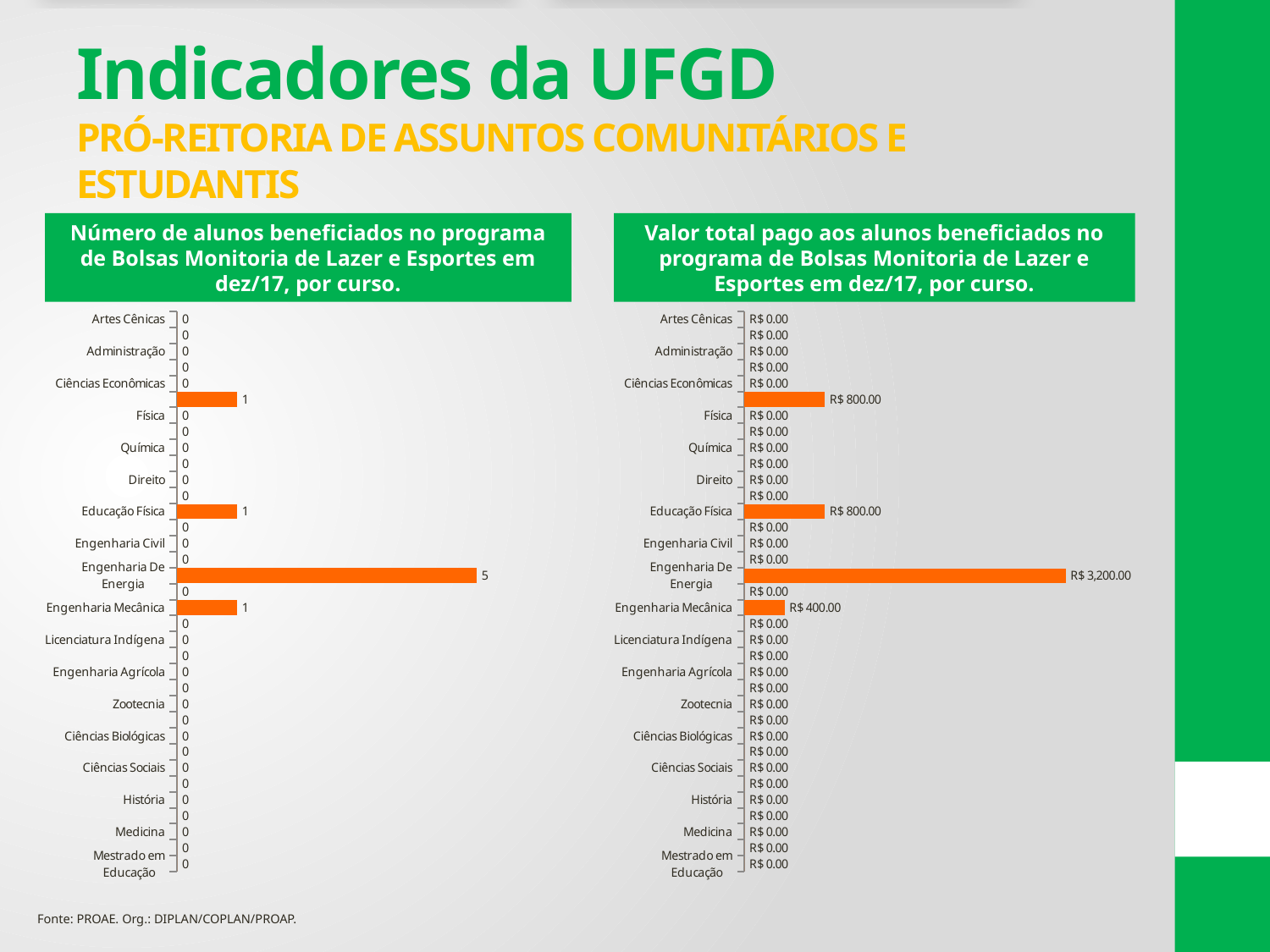
In the right chart (Valor total pago), what is the value for Engenharia Mecânica? R$ 400.00 In the left chart (Número de alunos beneficiados), what is the value for Medicina? 0 In the right chart (Valor total pago), which is larger: the value for Educação Física or the value for Engenharia Mecânica? Educação Física In the right chart (Valor total pago), what is the value for Engenharia De Energia? R$ 3,200.00 In the left chart (Número de alunos beneficiados), what is the value for Educação Física? 1 What type of chart is the left chart (Número de alunos beneficiados)? Bar chart In the left chart (Número de alunos beneficiados), which course has the highest number of students? Engenharia De Energia In the left chart (Número de alunos beneficiados), how many students are shown for Engenharia De Energia? 5 In the left chart (Número de alunos beneficiados), what is the value for Engenharia Mecânica? 1 In the right chart (Valor total pago), what is the value for Educação Física? R$ 800.00 In the right chart (Valor total pago), what is the difference between the values for Engenharia De Energia and Engenharia Mecânica? R$ 2,800.00 In the right chart (Valor total pago), what is the value for Física? R$ 0.00